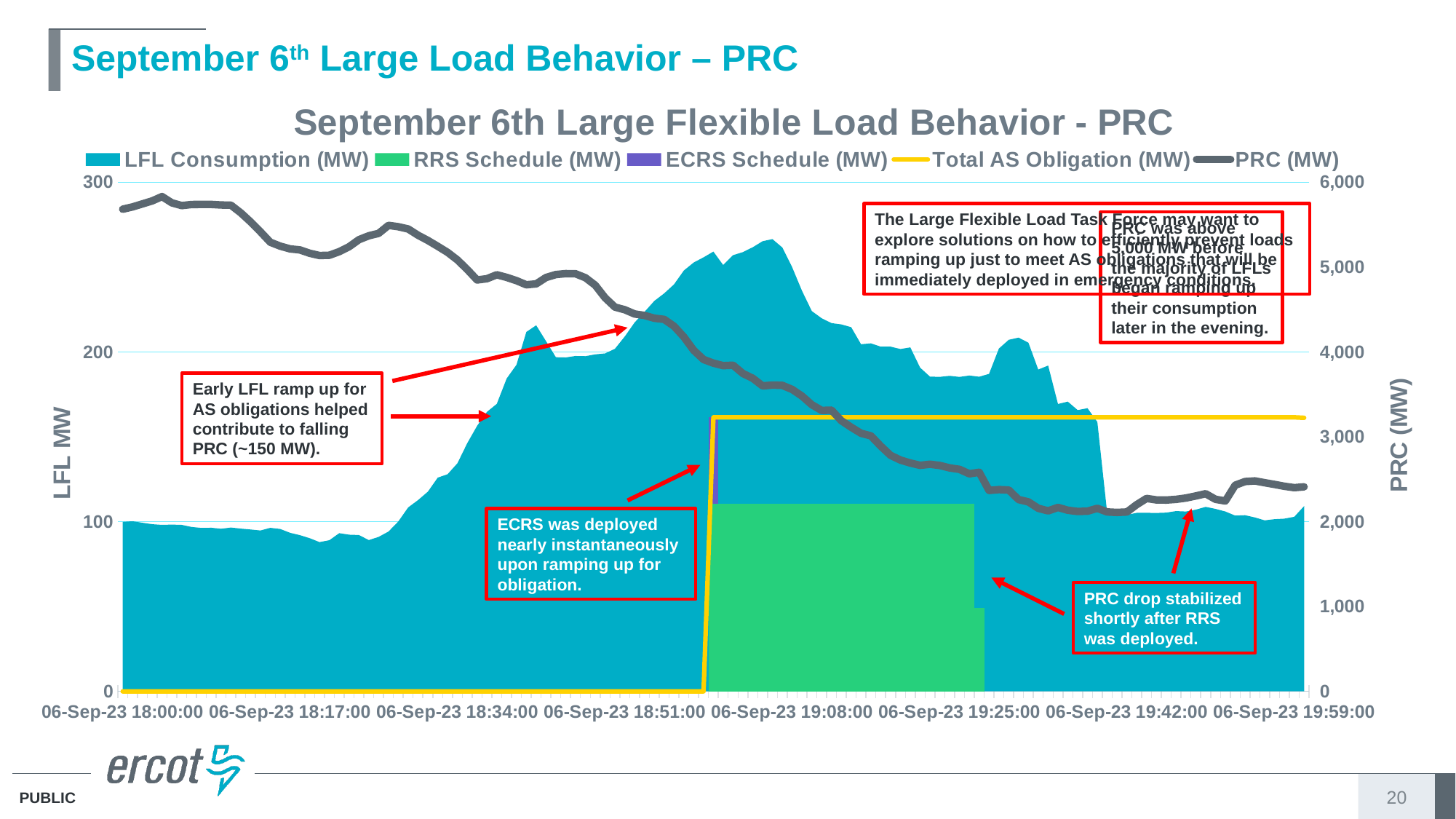
Which is larger, the LFL Consumption (MW) value at 06-Sep-23 18:00:00 or at 06-Sep-23 19:08:00? 06-Sep-23 19:08:00 What is the label of the right-hand vertical axis? PRC (MW) Is the PRC (MW) value at 06-Sep-23 18:00:00 greater or less than 5,000? greater Is the PRC (MW) value at 06-Sep-23 19:59:00 greater or less than 3,000? less What is the title of the chart? September 6th Large Flexible Load Behavior - PRC Which is larger, the PRC (MW) value at 06-Sep-23 18:00:00 or at 06-Sep-23 19:59:00? 06-Sep-23 18:00:00 How many time labels are shown along the x axis? 8 How many series does the chart legend list? 5 Does the PRC (MW) line generally rise or fall from 18:00:00 to 19:59:00? fall Is the LFL Consumption (MW) value at 06-Sep-23 18:00:00 greater or less than 200? less